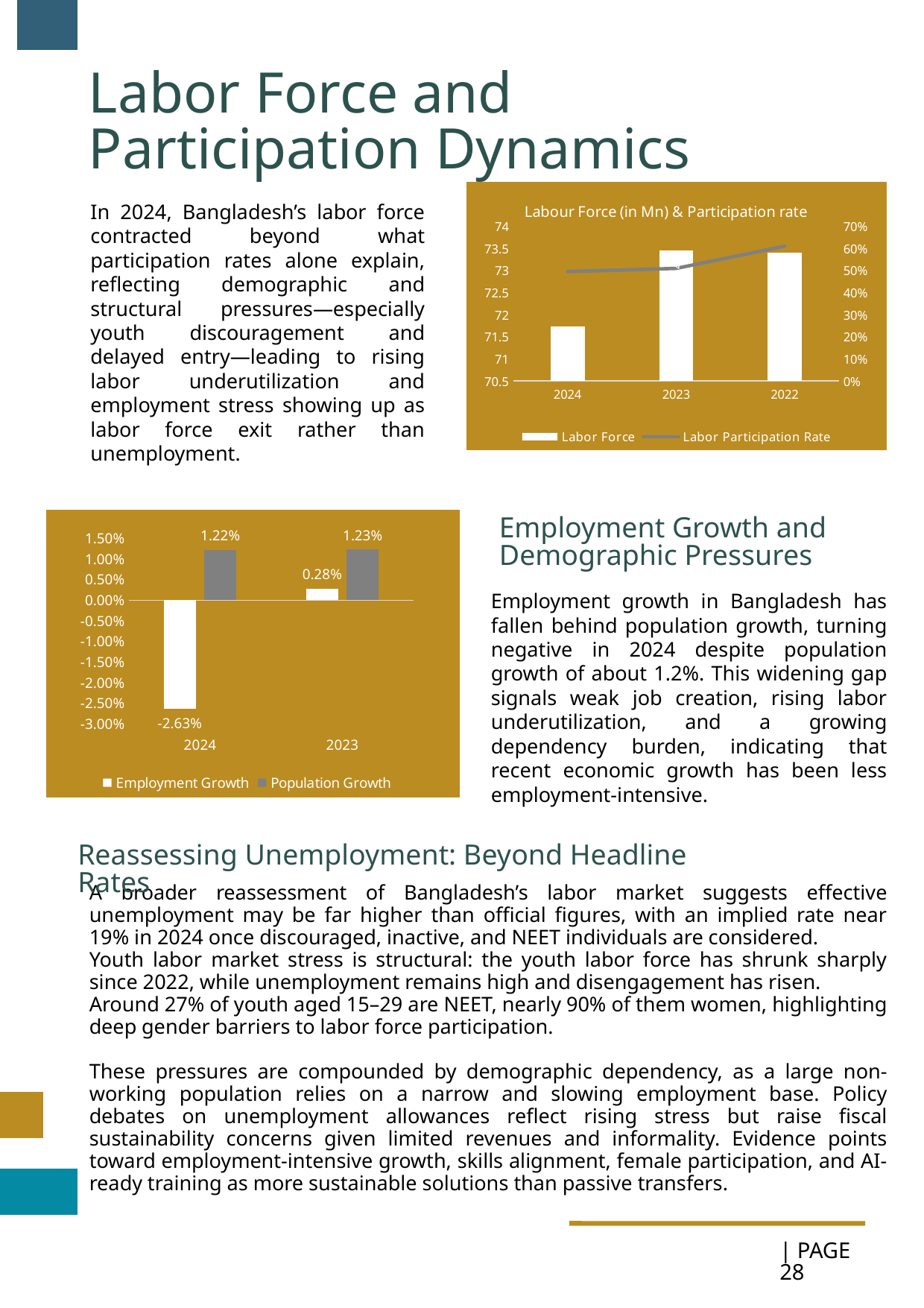
In the bottom-left chart, what is the difference between Population Growth and Employment Growth in 2024? 3.85 percentage points In the bottom-left chart, what is the Employment Growth value for 2023? 0.28% In the 'Labour Force (in Mn) & Participation rate' chart, is the Labor Participation Rate for 2022 greater or less than 50%? greater In the bottom-left chart, how many series does the legend list? 2 In the bottom-left chart, which is larger in 2023: Employment Growth or Population Growth? Population Growth In the bottom-left chart, which year has the lower Employment Growth? 2024 In the bottom-left chart, what is the Population Growth value for 2023? 1.23% In the bottom-left chart, what is the Employment Growth value for 2024? -2.63% In the 'Labour Force (in Mn) & Participation rate' chart, is the Labor Force value for 2024 greater or less than 72? less In the 'Labour Force (in Mn) & Participation rate' chart, which year has the lowest Labor Force bar? 2024 In the 'Labour Force (in Mn) & Participation rate' chart, how many years are shown on the x axis? 3 In the bottom-left chart, what is the Population Growth value for 2024? 1.22%